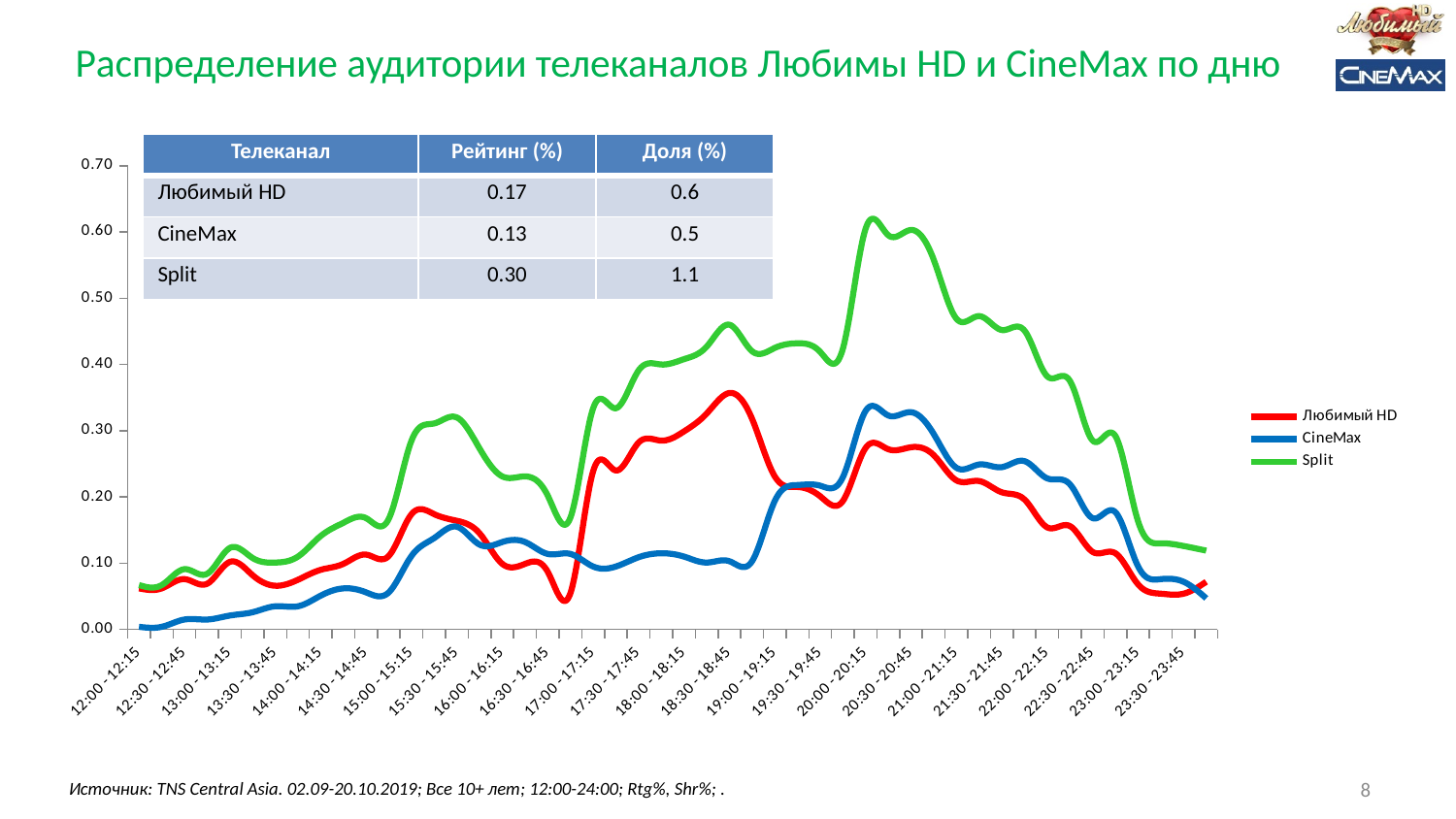
At 18:30 - 18:45, which series has the higher value, Любимый HD or CineMax? Любимый HD At 20:30 - 20:45, which series has the higher value, CineMax or Любимый HD? CineMax Which series reaches the highest value anywhere on the chart? Split Is the value for Любимый HD at 18:30 - 18:45 greater or less than 0.30? greater What colour is the Split line in the chart? green Is the value for CineMax at 12:00 - 12:15 greater or less than 0.10? less Which series has the lowest value at 12:00 - 12:15? CineMax Does the CineMax line rise or fall from 12:00 - 12:15 to 15:30 - 15:45? rise How many series does the chart legend list? 3 Is the value for Split at 20:00 - 20:15 greater or less than 0.50? greater Does the Split line rise or fall between 22:00 - 22:15 and 23:30 - 23:45? fall What kind of chart is shown on the slide? line chart